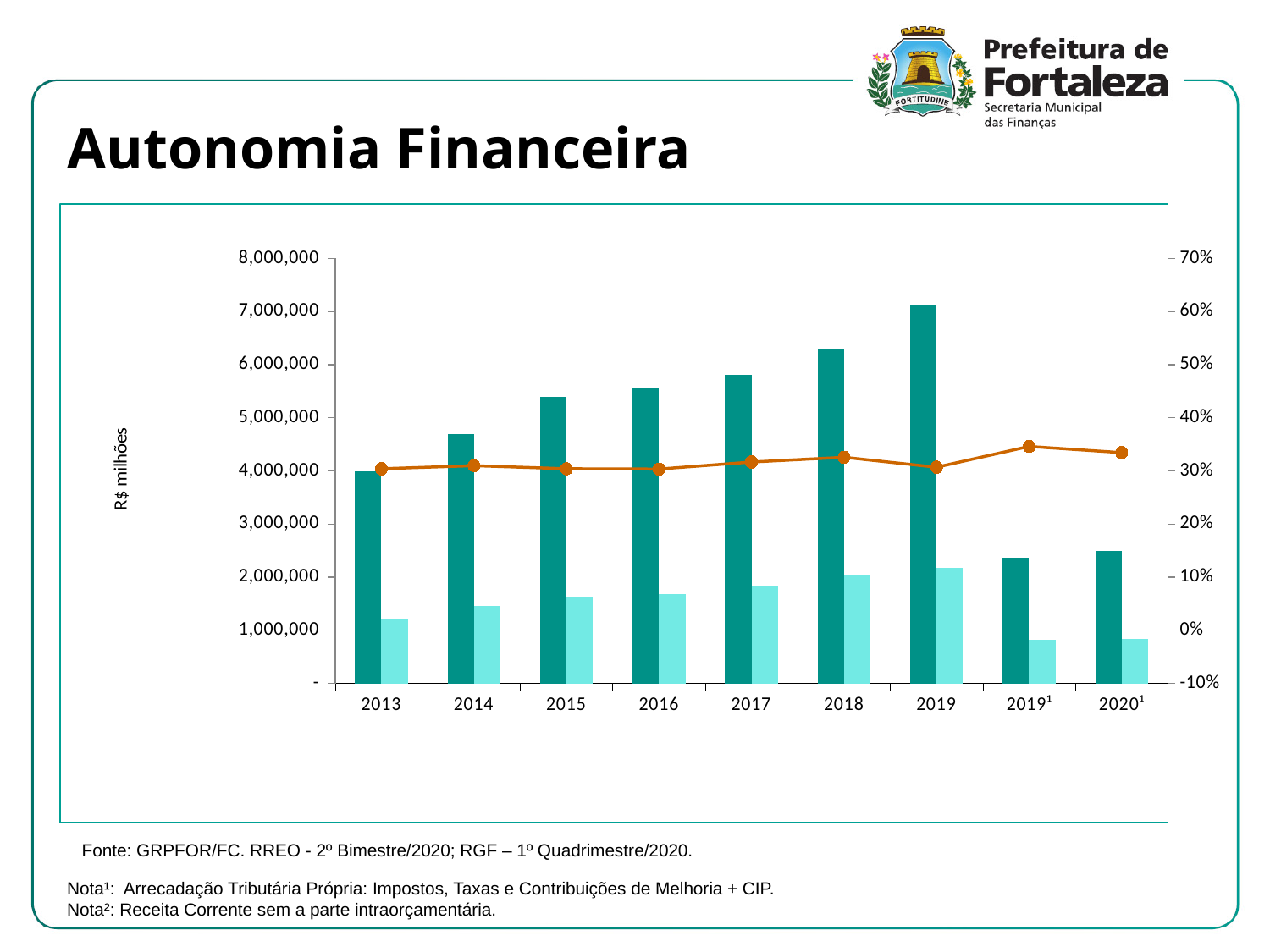
Which category has the tallest light teal bar? 2019 Do the dark teal bars rise or fall from 2013 to 2019? rise What is the label on the left vertical axis of the chart? R$ milhões Is the light teal bar for 2013 greater or less than 1,000,000? greater Which category has the tallest dark teal bar? 2019 Is the orange line value for 2019¹ greater or less than 30%? greater Is the dark teal bar for 2020¹ greater or less than 3,000,000? less Which category has the shortest dark teal bar? 2019¹ What kind of chart is shown on the slide? A bar chart combined with a line Which has the larger dark teal bar, 2017 or 2018? 2018 How many categories are shown along the x axis of the chart? 9